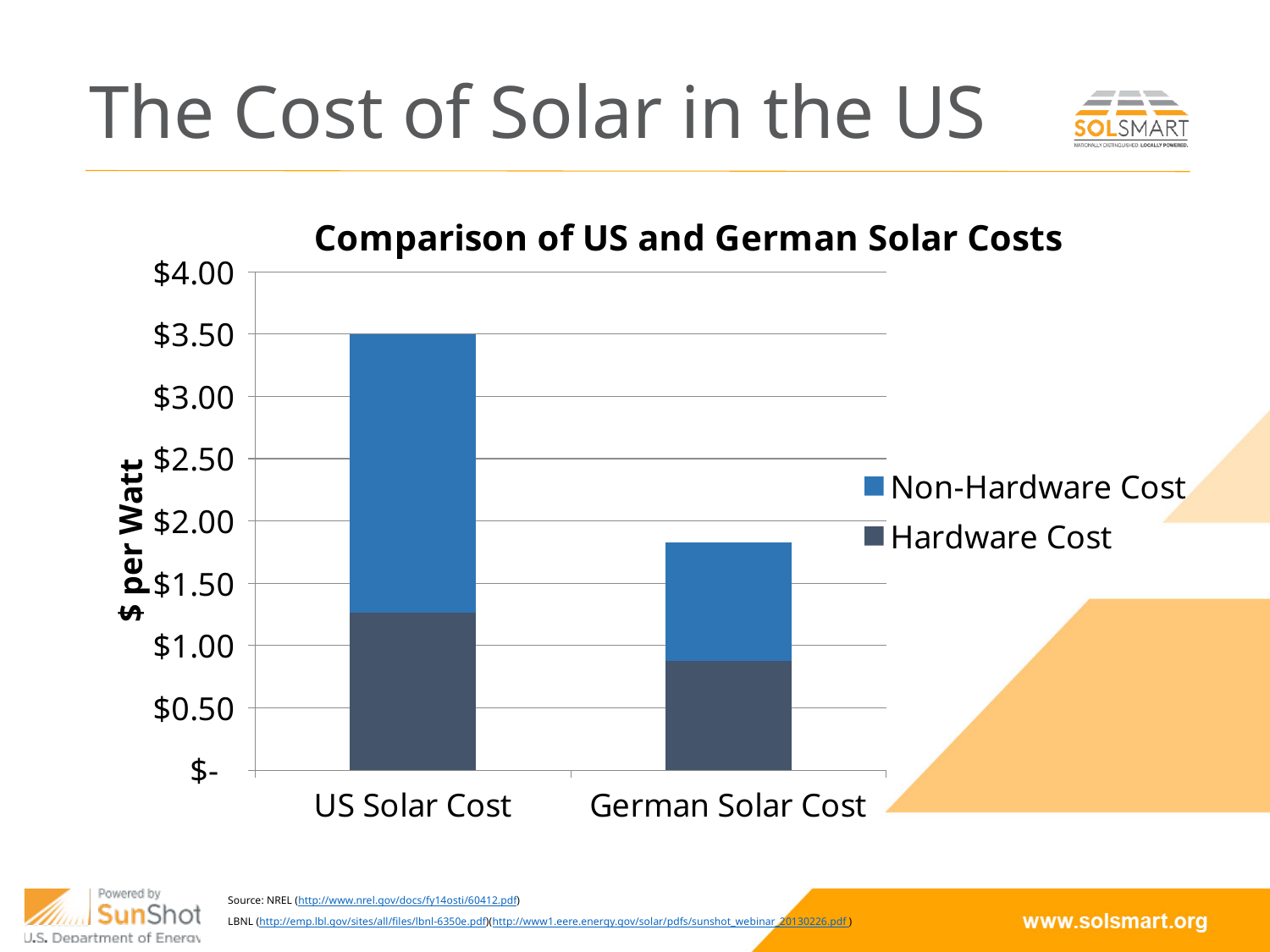
What kind of chart is shown on the slide? Stacked bar chart How many series does the chart legend list? 2 Which category has the highest total bar? US Solar Cost How many categories are shown on the x axis of the chart? 2 Is the total value for German Solar Cost greater or less than $2.00? less What is the title of the chart? Comparison of US and German Solar Costs What is the label of the vertical axis? $ per Watt Is the total value for US Solar Cost greater or less than $3.00? greater Is the Hardware Cost for German Solar Cost greater or less than $1.00? less Which category has the higher total cost, US Solar Cost or German Solar Cost? US Solar Cost Which category has the larger Hardware Cost, US Solar Cost or German Solar Cost? US Solar Cost